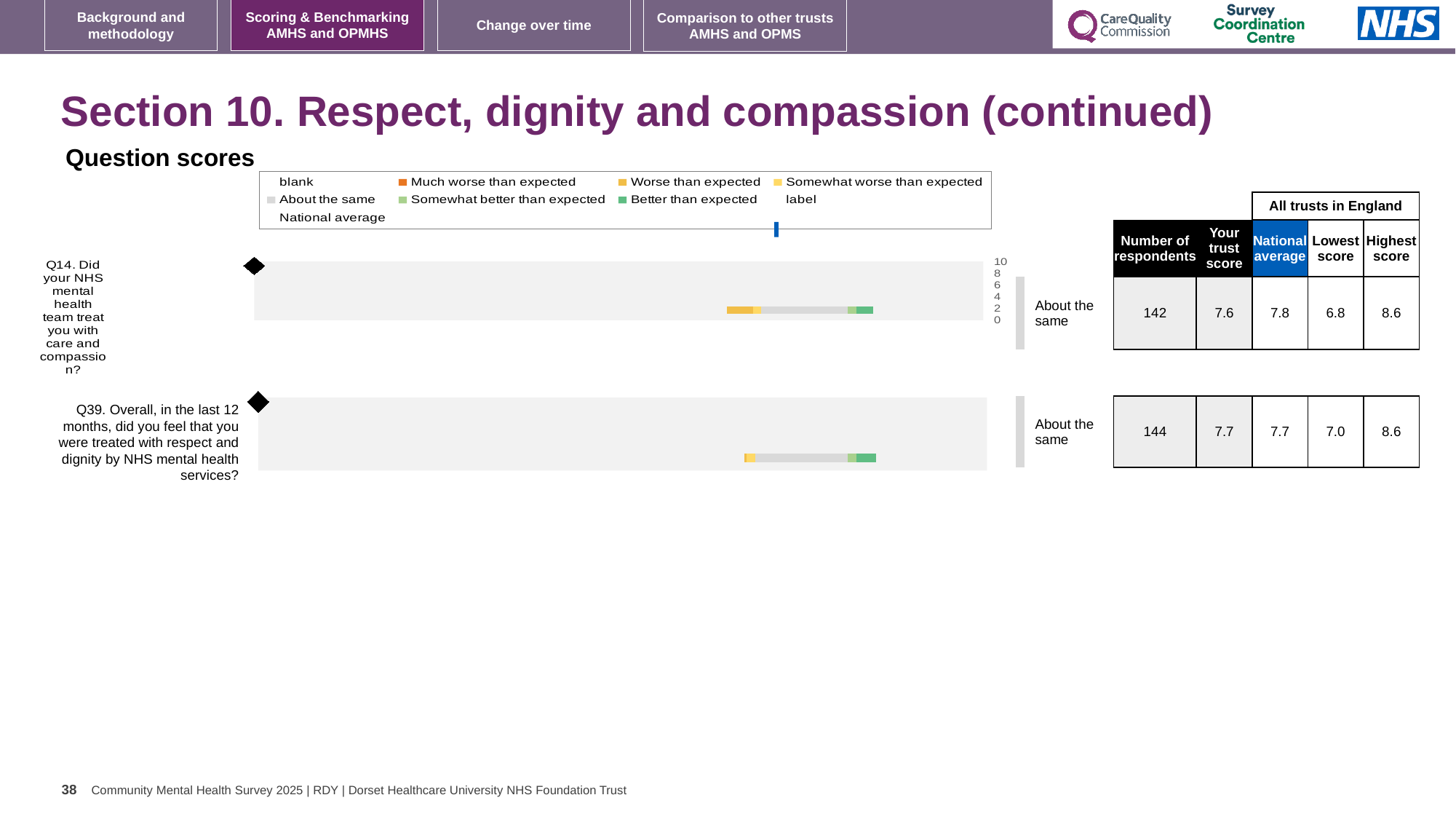
What is the difference between the highest score and the lowest score for Q14? 1.8 What is the maximum value shown on the score axis of the Q14 chart? 10 How many questions are plotted in the question scores charts on this slide? 2 What is the national average score shown for Q39? 7.7 What is the difference between the highest score and the lowest score for Q39? 1.6 What is the lowest score among all trusts in England shown for Q39? 7.0 What kind of chart is used to show the question scores for Q14 and Q39? bar chart What is the number of respondents shown for Q14? 142 What benchmark category is shown next to the Q39 chart? About the same What is the 'Your trust score' value shown for Q14? 7.6 For Q14, which is larger: the trust score or the national average? national average What is the highest score among all trusts in England shown for Q14? 8.6